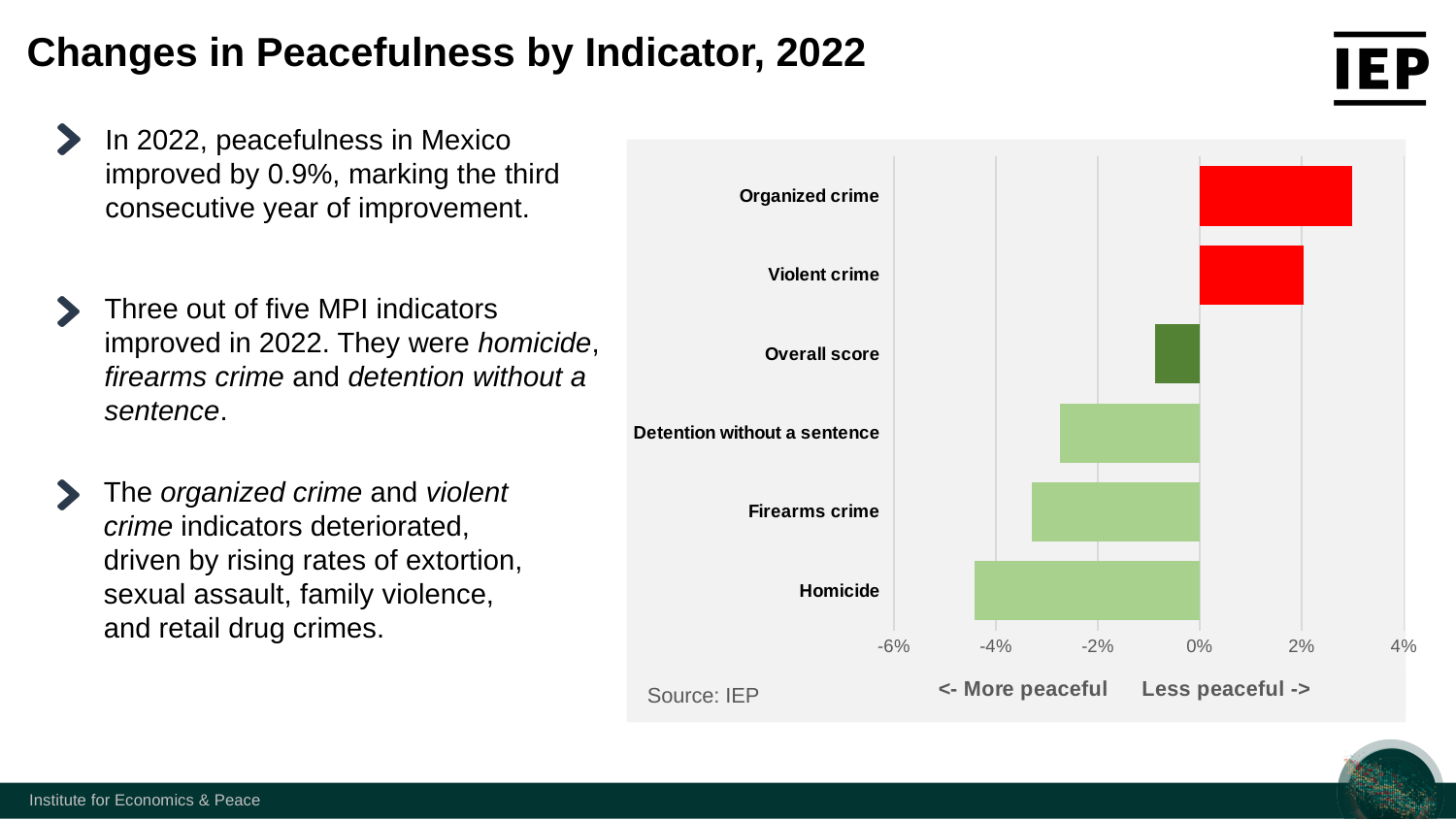
Which has a lower value, Firearms crime or Detention without a sentence? Firearms crime Which indicator has the lowest (most negative) value in the chart? Homicide Is the value for Firearms crime greater or less than -2%? less How many indicators are plotted in the chart? 6 Is the value for Homicide greater or less than -4%? less Is the value for Organized crime greater or less than 2%? greater Which has a larger value, Organized crime or Violent crime? Organized crime Which indicator has the highest (most positive) value in the chart? Organized crime What is the source cited below the chart? IEP What kind of chart is shown on the slide? bar chart What colour are the bars for Organized crime and Violent crime? red